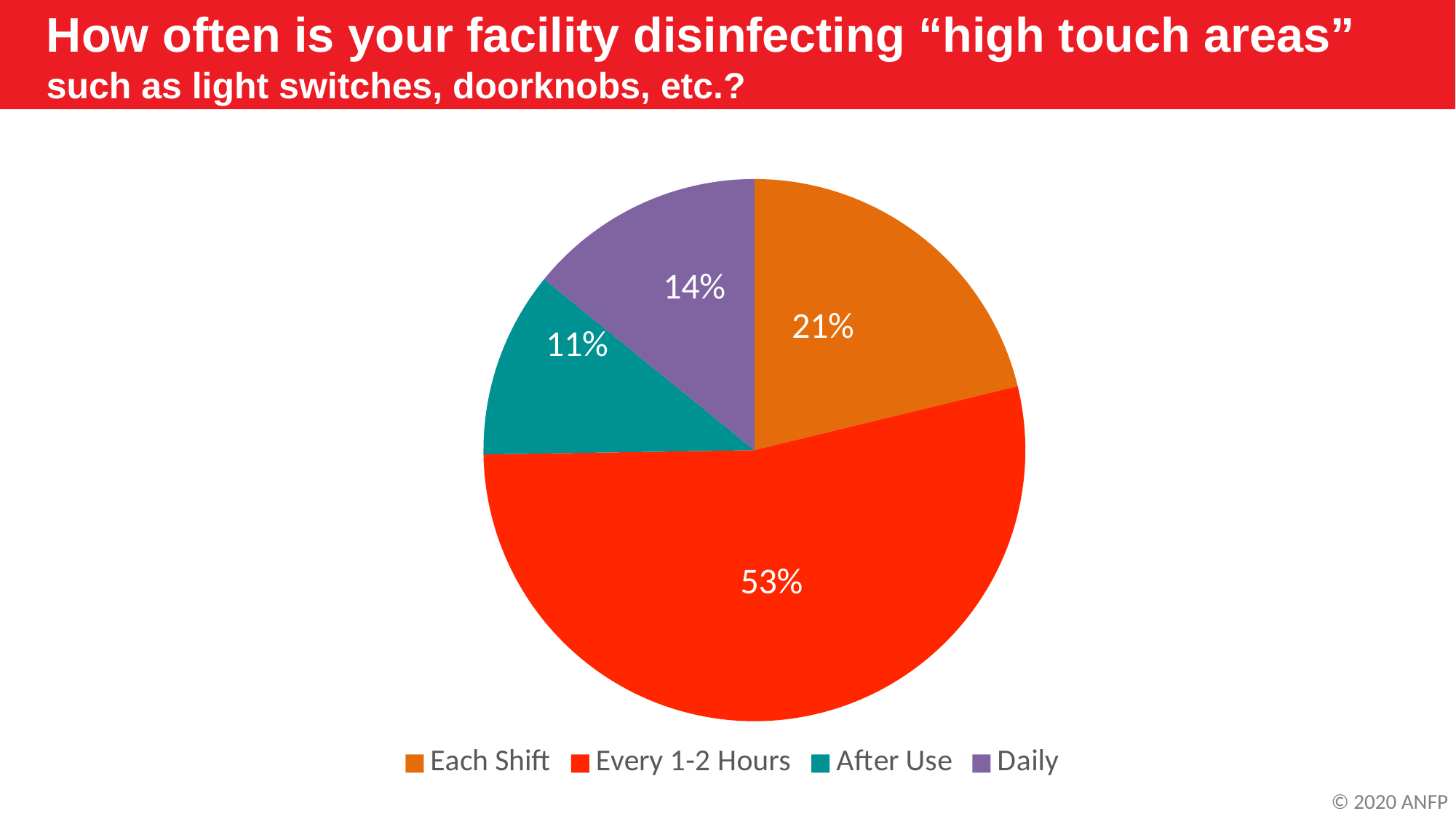
What colour is the slice for Every 1-2 Hours? red What percentage of facilities disinfect high touch areas Each Shift? 21% Which category has the smallest slice of the pie? After Use Which is larger, the share for Daily or the share for After Use? Daily What kind of chart is shown on the slide? pie chart Which category has the largest slice of the pie? Every 1-2 Hours How many categories does the pie chart show? 4 What share of facilities disinfect high touch areas Every 1-2 Hours? 53% Which legend entry is shown in purple? Daily What is the difference in percentage points between Every 1-2 Hours and Each Shift? 32 What percentage of facilities disinfect high touch areas After Use? 11% What percentage of facilities disinfect high touch areas Daily? 14%